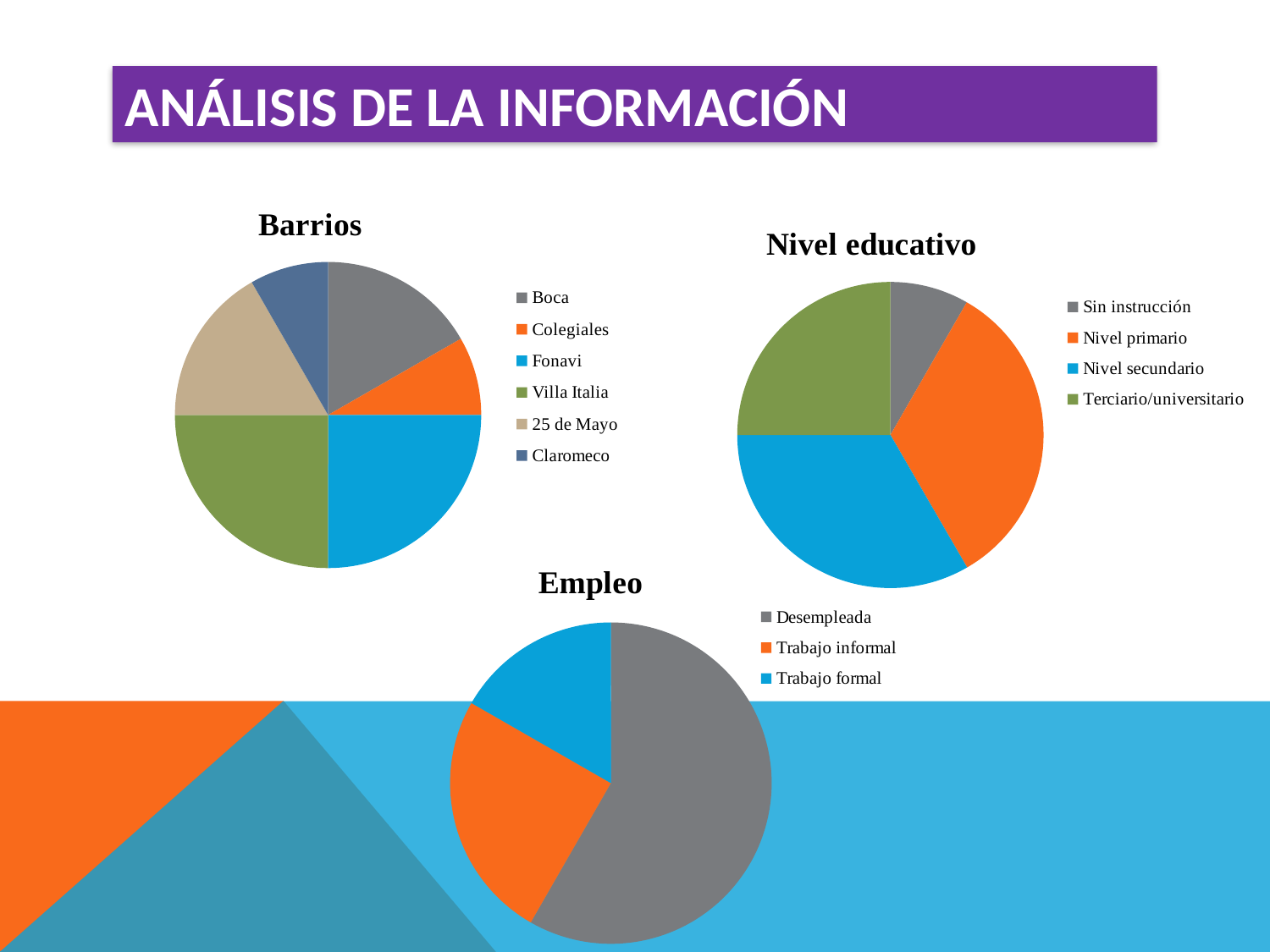
How many entries does the legend of the 'Nivel educativo' chart list? 4 How many categories does the 'Empleo' pie chart show? 3 In the 'Nivel educativo' chart, which category has the smallest slice? Sin instrucción In the 'Nivel educativo' chart, which is larger, Terciario/universitario or Sin instrucción? Terciario/universitario In the 'Empleo' chart, which is larger, Desempleada or Trabajo formal? Desempleada What kind of chart is the 'Empleo' chart? pie chart What colour represents 'Nivel primario' in the 'Nivel educativo' chart? orange What kind of chart is the 'Barrios' chart? pie chart In the 'Barrios' chart, which is larger, Fonavi or Colegiales? Fonavi In the 'Empleo' chart, which category has the largest slice? Desempleada How many categories does the 'Barrios' pie chart show? 6